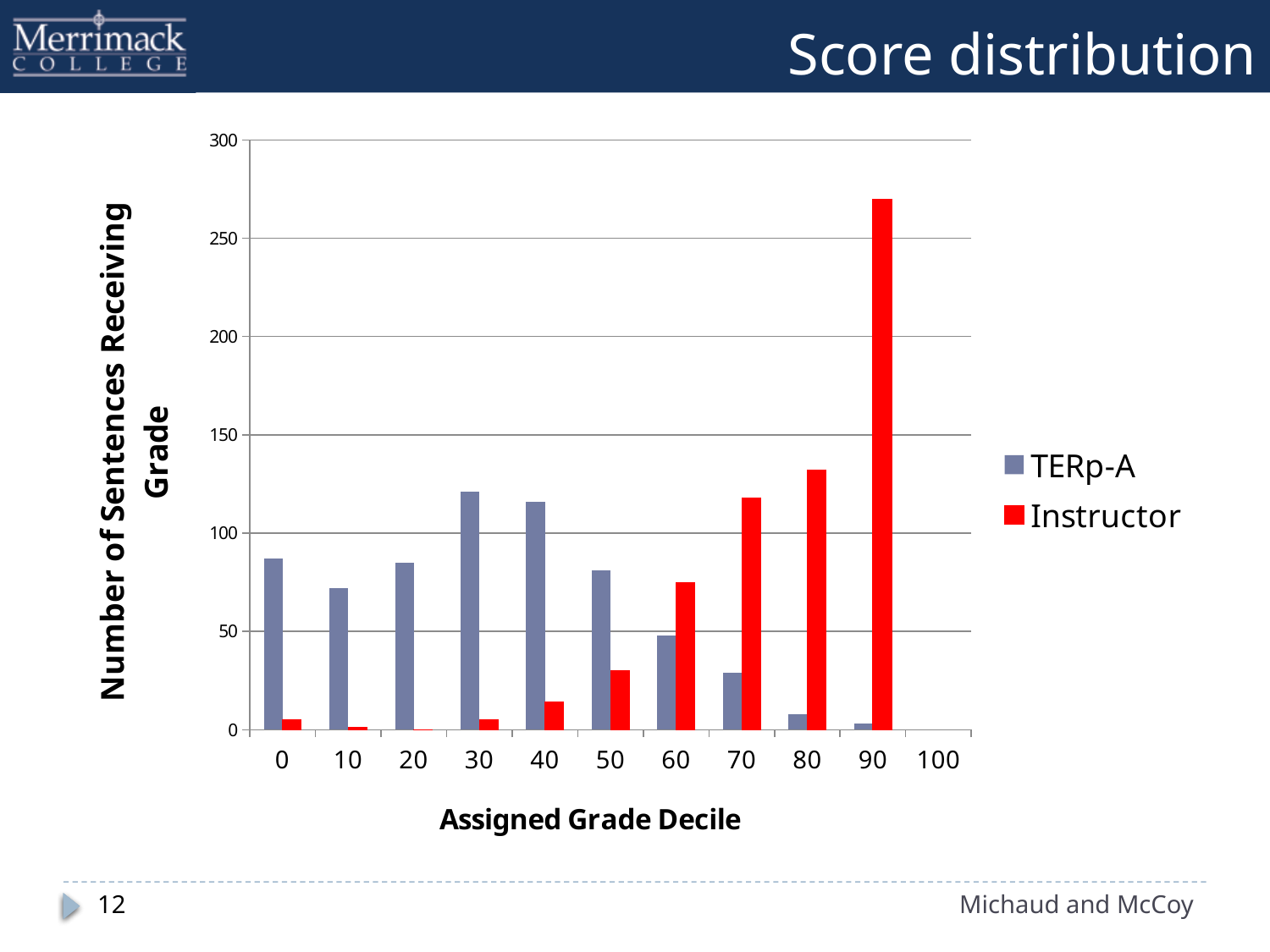
For which grade decile is the Instructor value highest? 90 How many series does the legend list? 2 What kind of chart is shown on the slide? bar chart How many grade decile categories are shown on the x axis? 11 Is the Instructor value for decile 80 greater or less than 100? greater Is the Instructor value for decile 90 greater or less than 250? greater At decile 60, which series has the larger value, TERp-A or Instructor? Instructor Is the TERp-A value for decile 70 greater or less than 50? less Do the Instructor values generally rise or fall as the grade decile increases from 0 to 90? rise What is the title of the x axis? Assigned Grade Decile At decile 50, which series has the larger value, TERp-A or Instructor? TERp-A